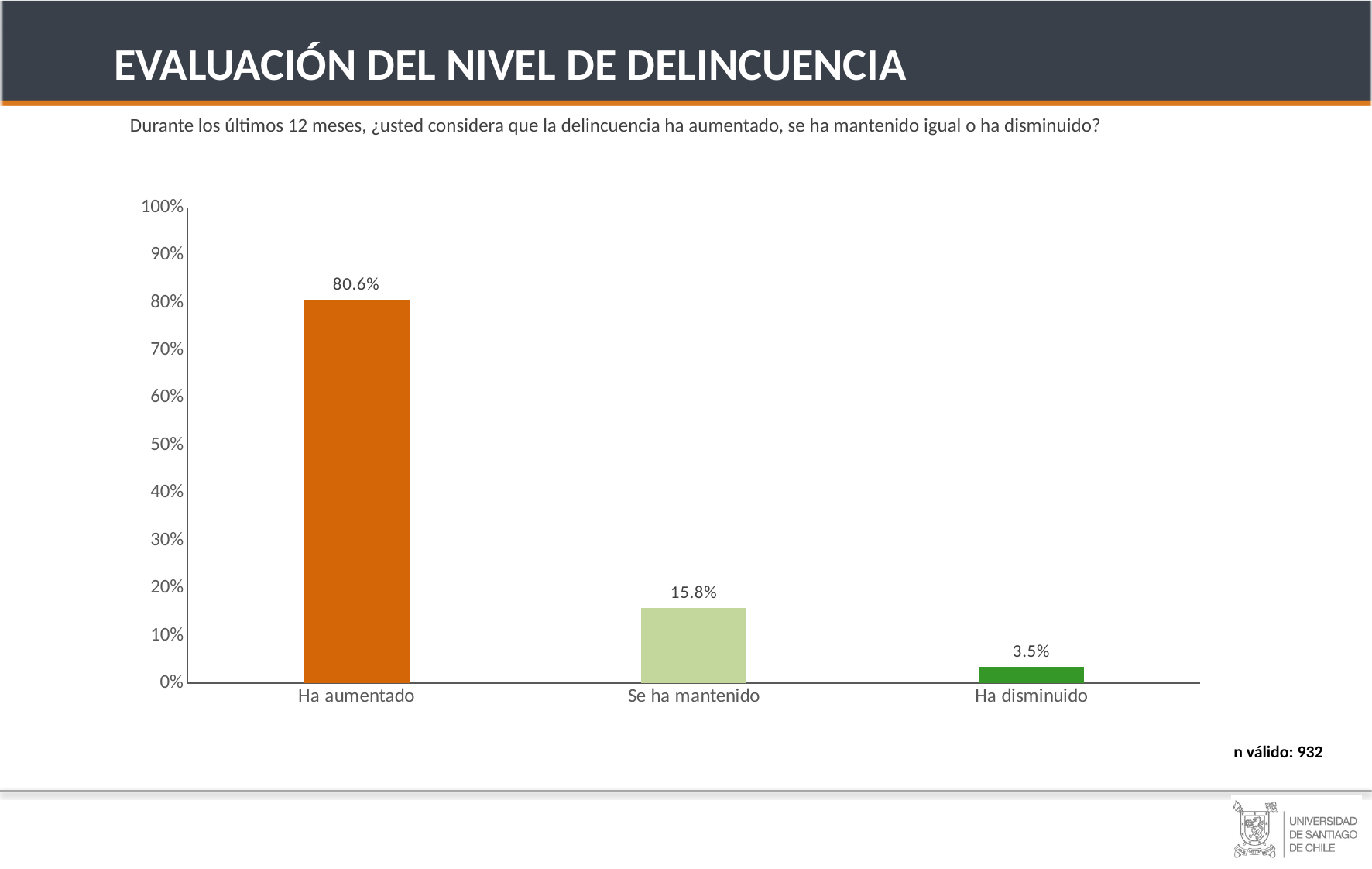
Is the value for "Ha aumentado" greater or less than 70%? greater Which category has the lowest value? Ha disminuido Which is larger, the value for "Se ha mantenido" or the value for "Ha disminuido"? Se ha mantenido What is the valid sample size (n válido) shown on the slide? 932 What kind of chart is shown on the slide? bar chart Which category has the highest value? Ha aumentado What is the difference between the values for "Ha aumentado" and "Se ha mantenido"? 64.8% What is the difference between the values for "Se ha mantenido" and "Ha disminuido"? 12.3% What is the value for "Ha aumentado"? 80.6% What is the value for "Se ha mantenido"? 15.8% How many categories are shown on the x axis? 3 What is the value for "Ha disminuido"? 3.5%